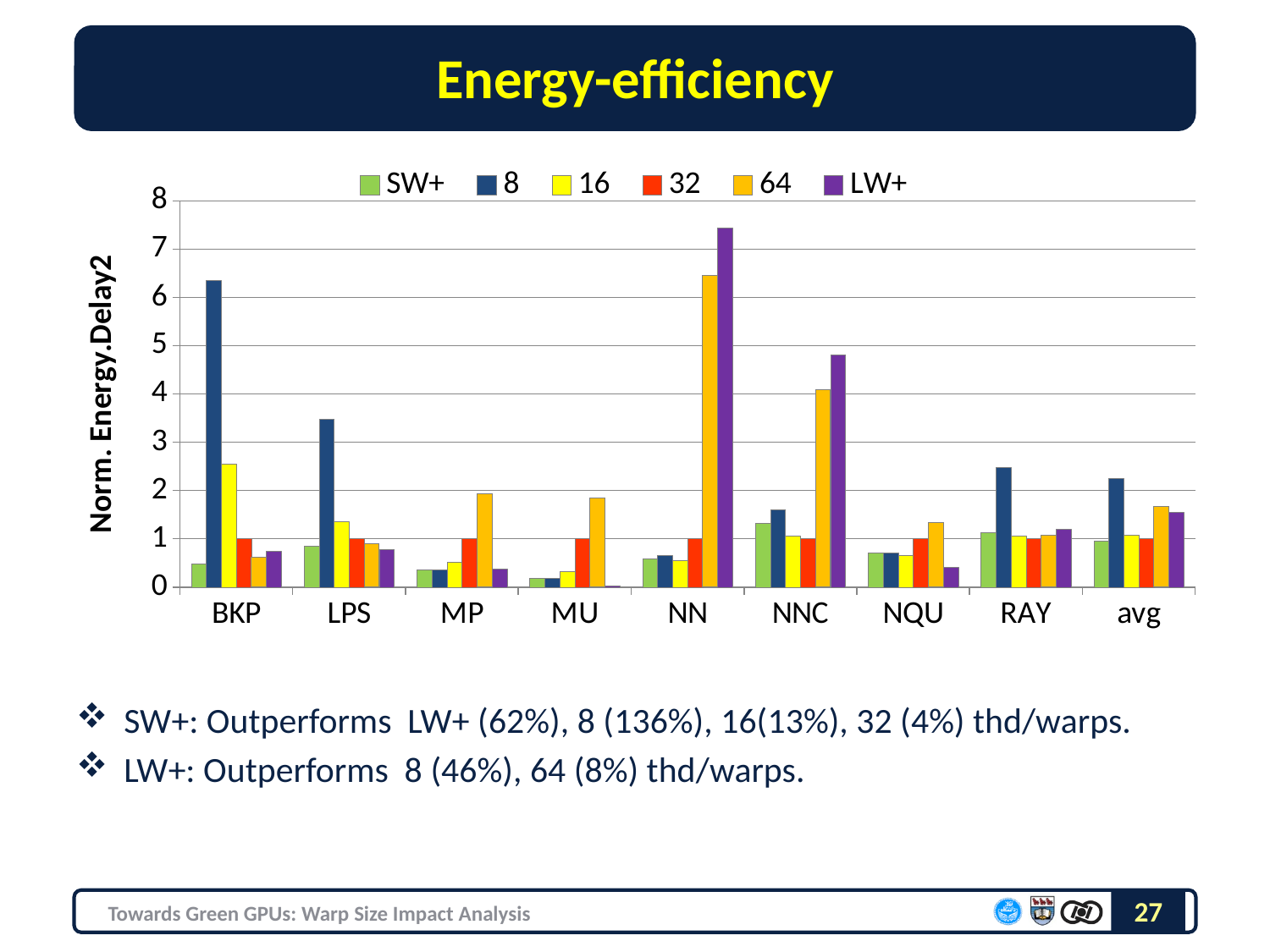
Which category has the highest value for the LW+ series? NN How many categories are shown along the x axis? 9 What is the label of the y axis? Norm. Energy.Delay2 For BKP, which is larger: the '8' series or the '16' series? 8 Is the value of the '8' series for BKP greater or less than 6? greater How many series does the legend list? 6 For NN, which is larger: the '64' series or the LW+ series? LW+ What kind of chart is shown on the slide? bar chart Is the value of the LW+ series for NNC greater or less than 4? greater Is the value of the '64' series for NN greater or less than 6? greater Which category has the highest value for the '8' series? BKP Which category has the lowest value for the LW+ series? MU